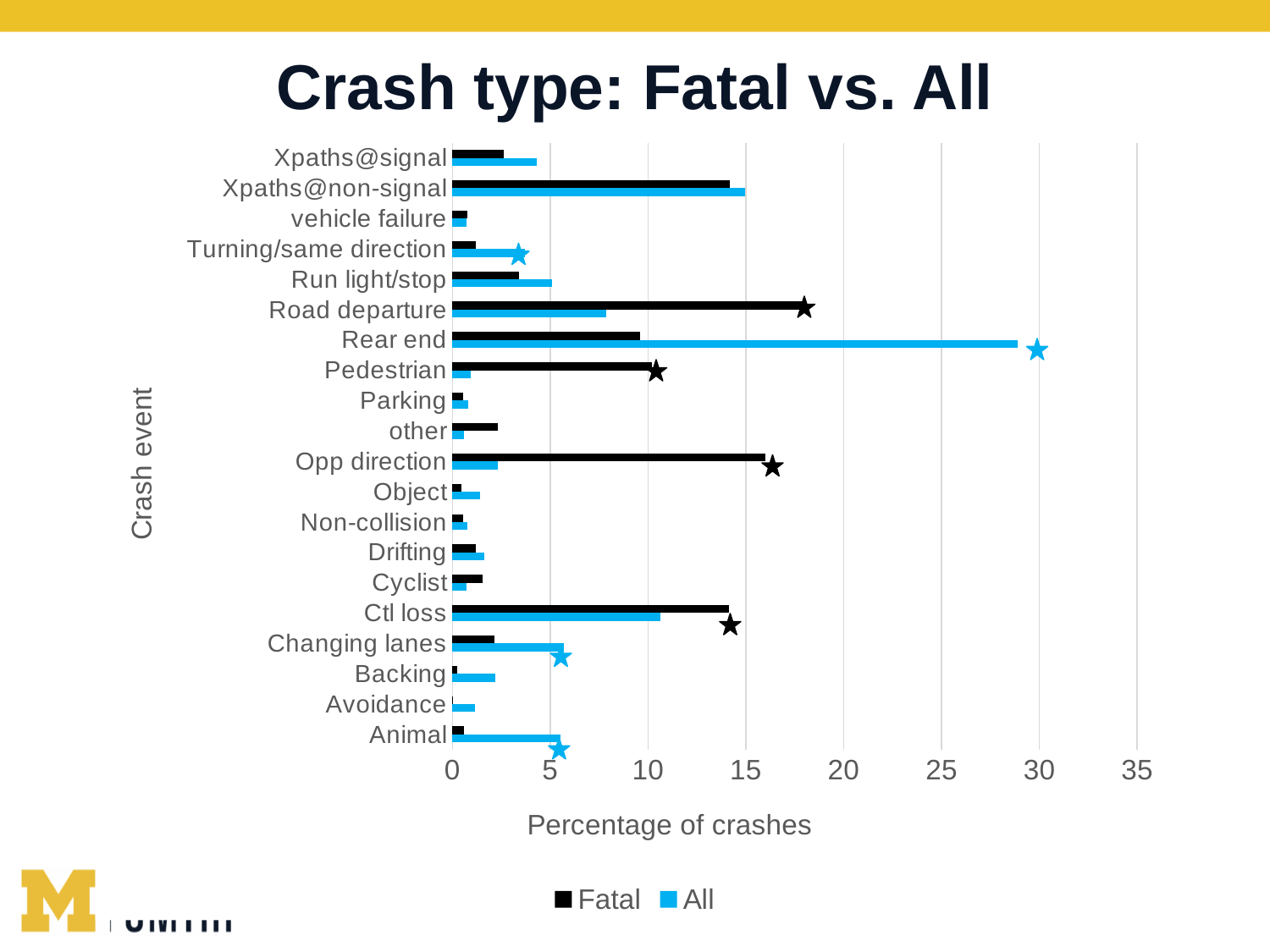
Is the All value for Rear end greater or less than 25? greater What is the label of the horizontal axis? Percentage of crashes Which crash event has the highest value for the All series? Rear end For Pedestrian, which series has the larger value, Fatal or All? Fatal How many series does the legend list? 2 Is the All value for Changing lanes greater or less than 10? less Is the Fatal value for Road departure greater or less than 15? greater For Rear end, which series has the larger value, Fatal or All? All What kind of chart is shown on the slide? bar chart Which crash event has the highest value for the Fatal series? Road departure How many crash event categories are plotted on the chart? 20